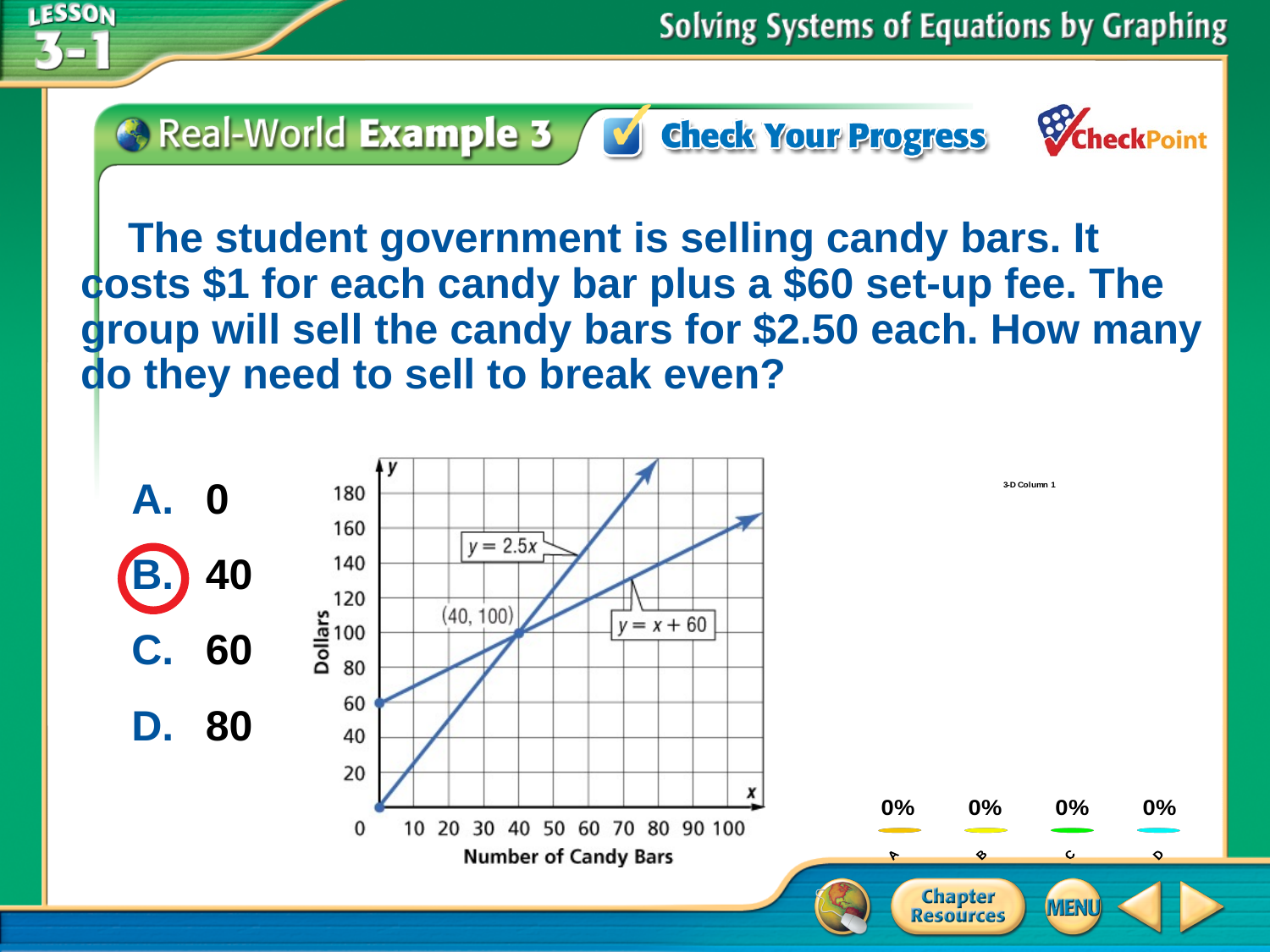
On the line chart, is the value of the line y = 2.5x at 20 candy bars greater or less than 60 dollars? less On the line chart, do the values of the line y = 2.5x rise or fall as the Number of Candy Bars increases? rise On the line chart, how many lines are plotted? 2 On the line chart, what is the value in Dollars of the line y = x + 60 when the Number of Candy Bars is 0? 60 On the line chart, which line is higher when the Number of Candy Bars is 20: y = 2.5x or y = x + 60? y = x + 60 On the line chart, what equation labels the steeper line? y = 2.5x What kind of chart is shown on the left of the slide, with the axes labeled Number of Candy Bars and Dollars? line chart On the line chart, is the value of the line y = x + 60 at 60 candy bars greater or less than 100 dollars? greater On the line chart, which line is higher when the Number of Candy Bars is 80: y = 2.5x or y = x + 60? y = 2.5x On the line chart, at what point do the two lines intersect, as labeled on the graph? (40, 100) On the line chart, what is the label of the x axis? Number of Candy Bars On the line chart, what is the value in Dollars of the line y = 2.5x when the Number of Candy Bars is 40? 100